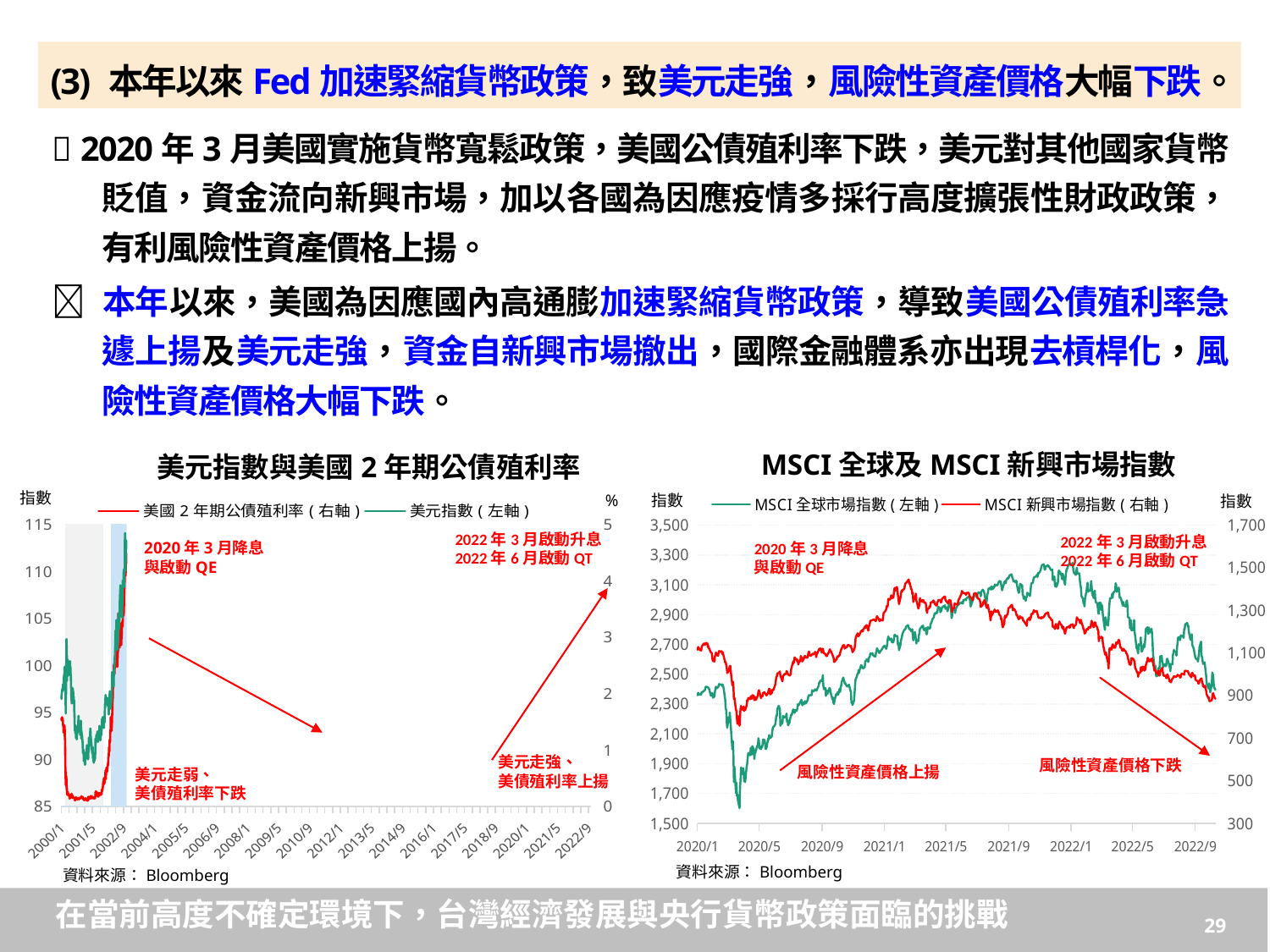
In the right chart (MSCI 全球及 MSCI 新興市場指數), is the lowest point of the MSCI 全球市場指數 in 2020 greater or less than 1,900? less How many series does the legend of the right chart (MSCI 全球及 MSCI 新興市場指數) list? 2 In the left chart (美元指數與美國 2 年期公債殖利率), what colour is the line for 美國 2 年期公債殖利率? red In the right chart (MSCI 全球及 MSCI 新興市場指數), which series is plotted on the right axis? MSCI 新興市場指數 How many series does the legend of the left chart (美元指數與美國 2 年期公債殖利率) list? 2 What kind of chart is the right chart titled MSCI 全球及 MSCI 新興市場指數? line chart What kind of chart is the left chart titled 美元指數與美國 2 年期公債殖利率? line chart In the left chart (美元指數與美國 2 年期公債殖利率), is the 美元指數 at the right end of the chart (2022/9) greater or less than 105? greater In the right chart (MSCI 全球及 MSCI 新興市場指數), is the MSCI 新興市場指數 at 2022/9 greater or less than 1,100? less In the right chart (MSCI 全球及 MSCI 新興市場指數), does the MSCI 全球市場指數 rise or fall between 2022/1 and 2022/9? fall How many x-axis tick labels are shown on the right chart (MSCI 全球及 MSCI 新興市場指數)? 9